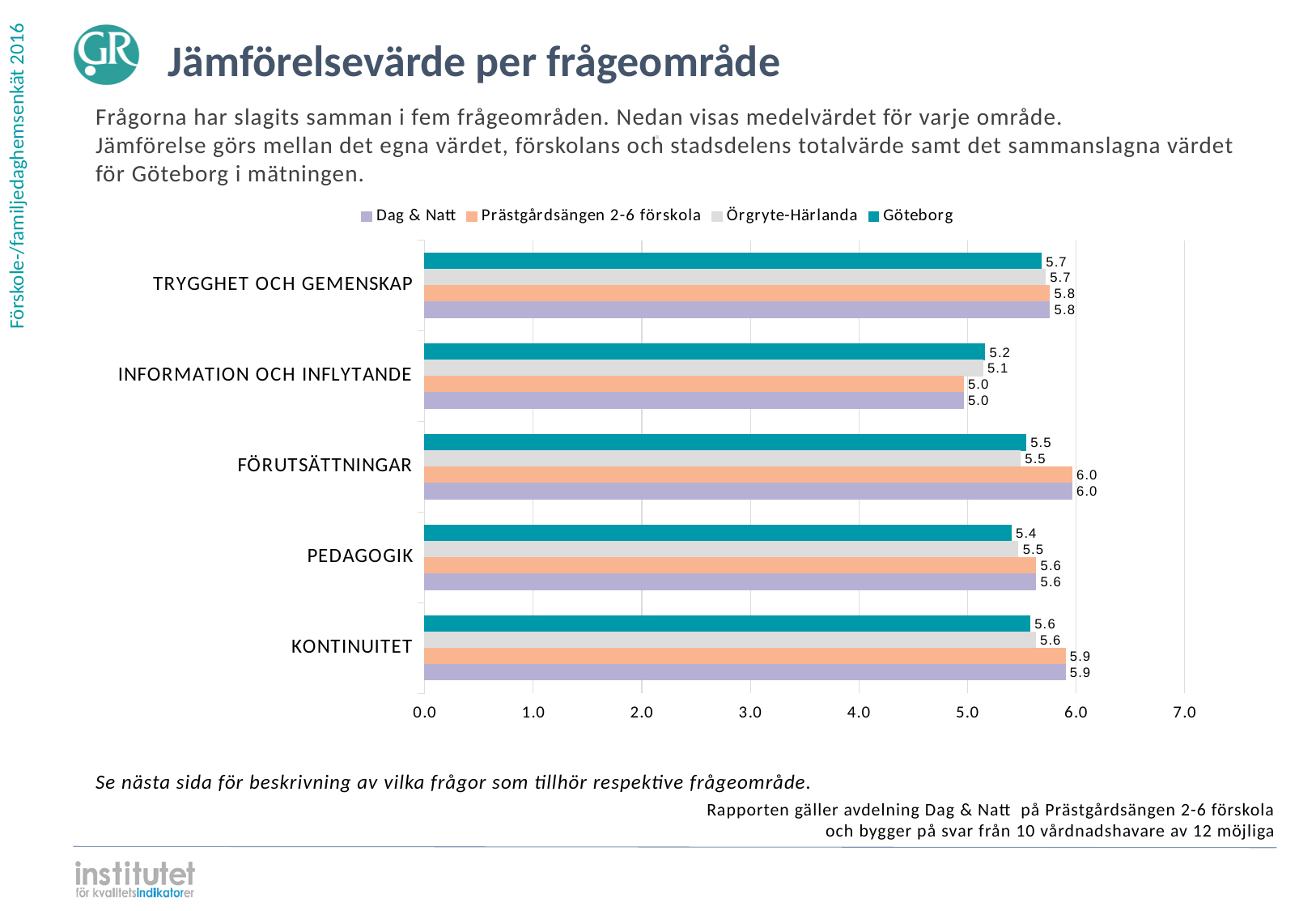
How many question areas (categories) are shown on the chart? 5 In which question area does Dag & Natt have its highest value? FÖRUTSÄTTNINGAR What is the value for Örgryte-Härlanda in PEDAGOGIK? 5.5 In which question area does Dag & Natt have its lowest value? INFORMATION OCH INFLYTANDE What is the value for Göteborg in INFORMATION OCH INFLYTANDE? 5.2 What is the value for Prästgårdsängen 2-6 förskola in KONTINUITET? 5.9 How many series does the legend list? 4 Which is larger in INFORMATION OCH INFLYTANDE: the Göteborg value or the Dag & Natt value? Göteborg What is the value for Dag & Natt in FÖRUTSÄTTNINGAR? 6.0 Which series is shown in teal in the legend? Göteborg What is the difference between the Dag & Natt value and the Göteborg value in FÖRUTSÄTTNINGAR? 0.5 What kind of chart is shown on the slide? Bar chart